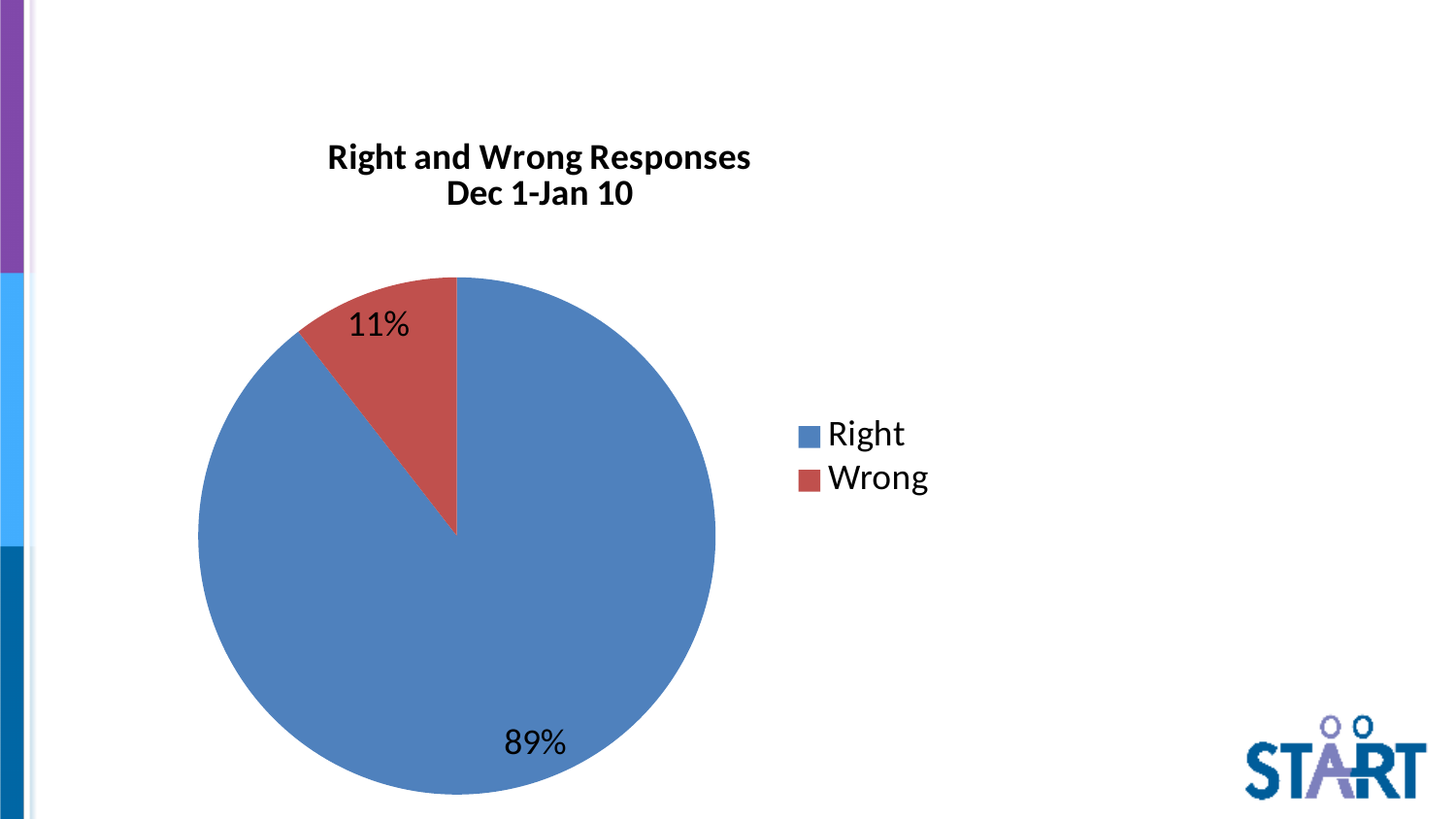
What is the title of the chart? Right and Wrong Responses Dec 1-Jan 10 What colour is the Wrong slice? red Which category has the smallest share of the pie? Wrong How many entries does the legend list? 2 Which is larger, the share of Right responses or the share of Wrong responses? Right What percentage of responses were Right? 89% What percentage of responses were Wrong? 11% What share of the pie does the Right slice represent? 89% How many categories does the pie chart show? 2 Which category has the largest share of the pie? Right What is the difference in percentage points between Right and Wrong responses? 78 What kind of chart is shown on the slide? pie chart